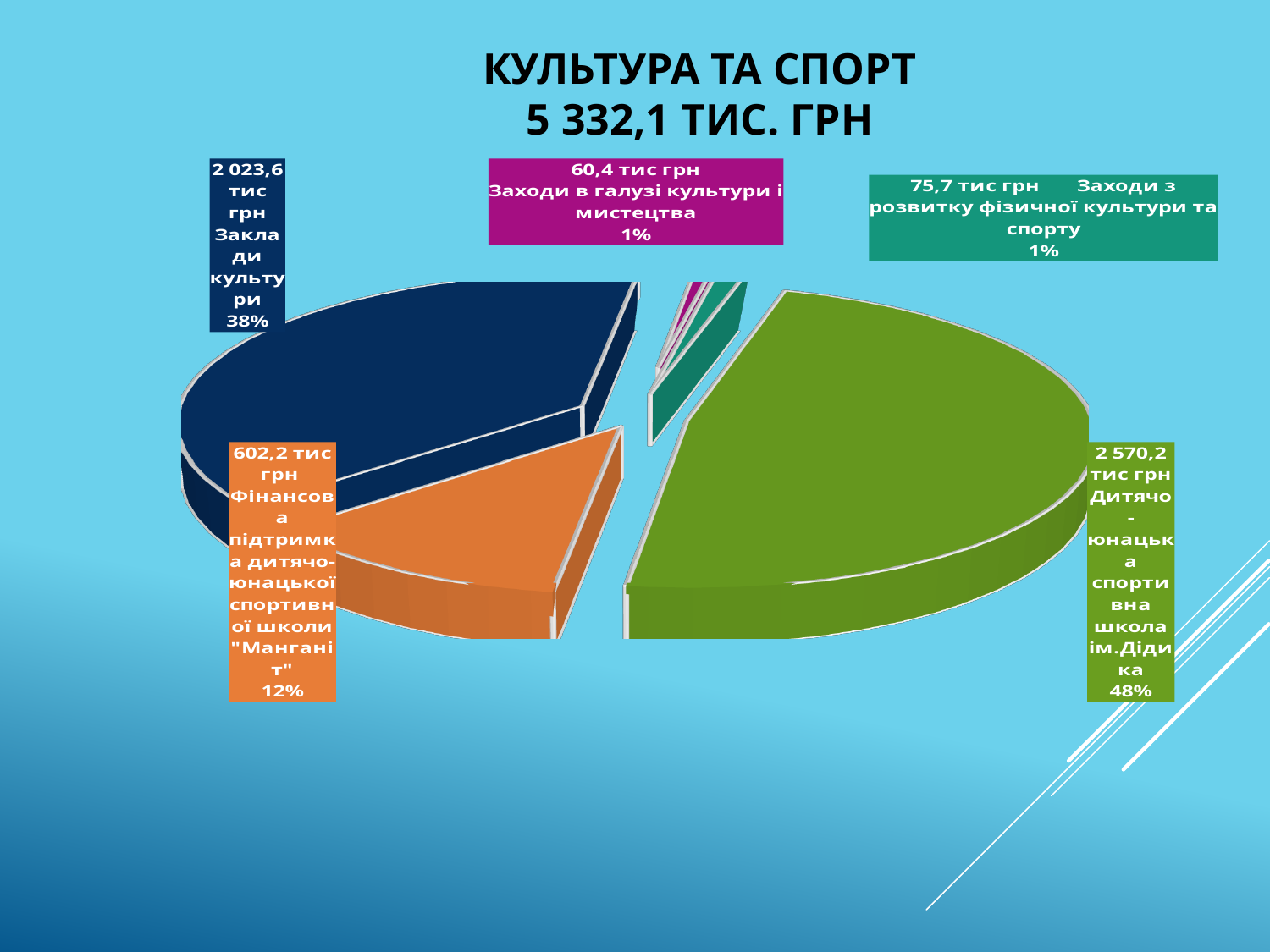
Which is larger: "Заклади культури" or "Фінансова підтримка дитячо-юнацької спортивної школи "Манганіт""? Заклади культури What is the value for "Заходи з розвитку фізичної культури та спорту"? 75,7 тис грн Which category has the largest slice of the pie? Дитячо-юнацька спортивна школа ім.Дідика Which category has the smallest value? Заходи в галузі культури і мистецтва What share of the pie does "Фінансова підтримка дитячо-юнацької спортивної школи "Манганіт"" represent? 12% What is the value for "Заклади культури"? 2 023,6 тис грн What is the value for "Дитячо-юнацька спортивна школа ім.Дідика"? 2 570,2 тис грн What is the value for "Заходи в галузі культури і мистецтва"? 60,4 тис грн What share of the pie does "Заклади культури" represent? 38% What type of chart is shown on the slide? pie chart How many slices does the pie chart have? 5 What total amount is stated in the chart title? 5 332,1 тис. грн